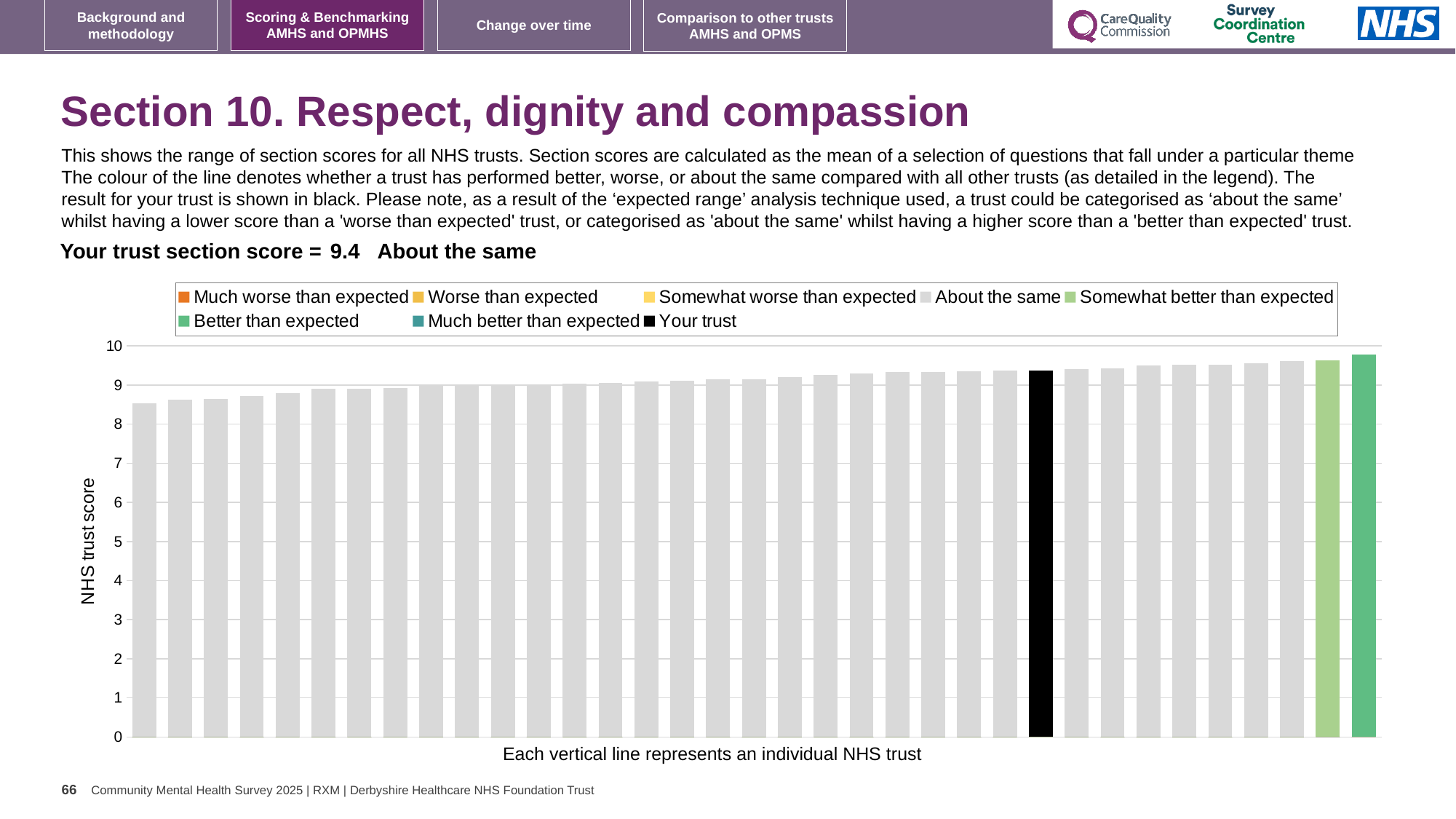
How many bars are shown in a green shade (somewhat better or better than expected)? 2 What colour is the bar representing your trust? black Is the value of the leftmost bar greater or less than 9? less Is the value of the black bar greater or less than 9? greater Do the bar values rise or fall from left to right across the chart? rise Is the value of the leftmost bar greater or less than 8? greater What is the section score for your trust shown on the slide? 9.4 What kind of chart is shown on the slide? bar chart Which category is your trust placed in for this section? About the same What is the label on the vertical axis of the chart? NHS trust score How many entries does the chart legend list? 8